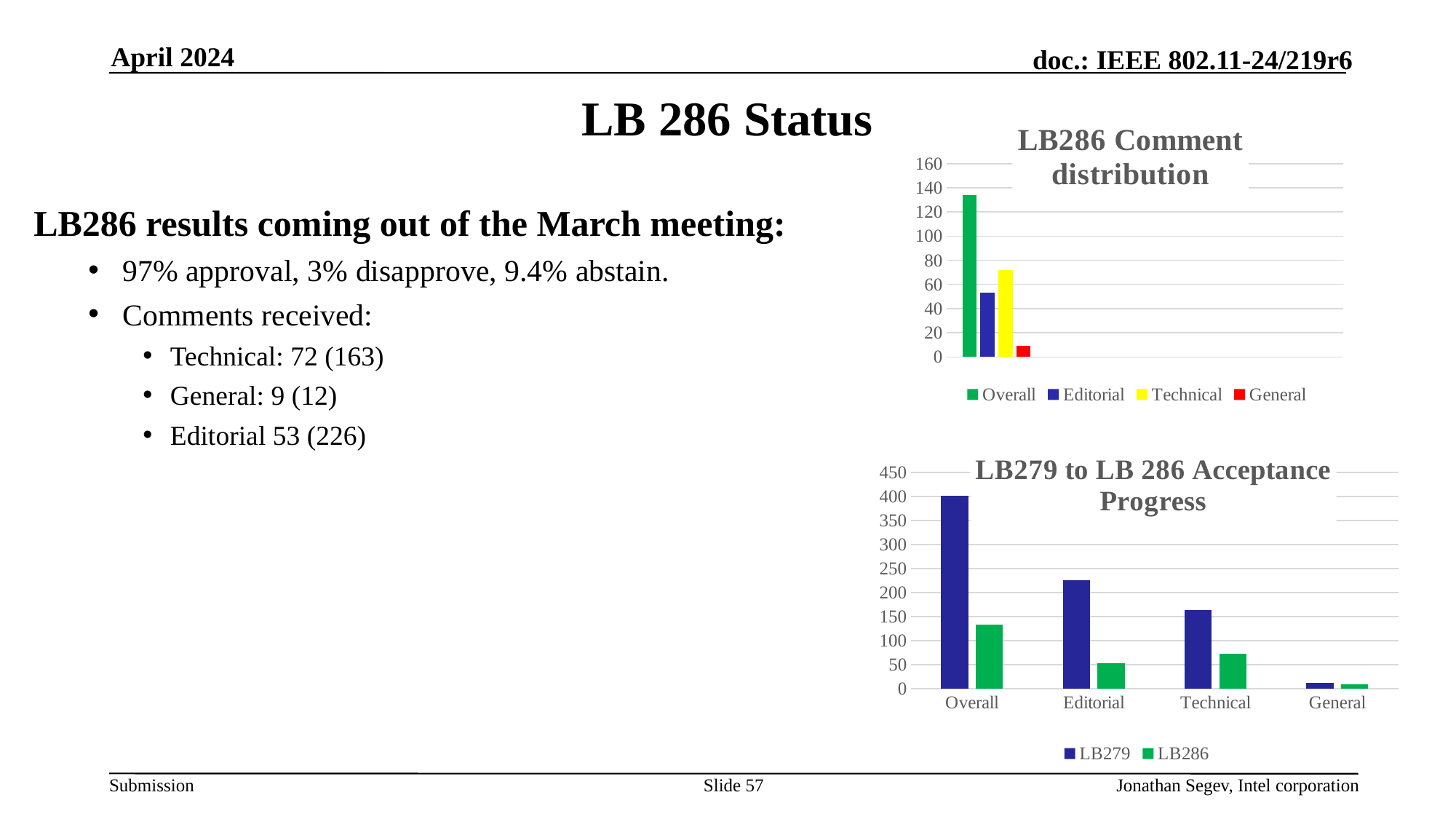
In the LB286 Comment distribution chart, what kind of chart is shown? bar chart In the LB279 to LB 286 Acceptance Progress chart, how many series does the legend list? 2 In the LB286 Comment distribution chart, which series has the shortest bar? General In the LB279 to LB 286 Acceptance Progress chart, is the LB279 value for Overall greater or less than 350? greater In the LB286 Comment distribution chart, is the value for Overall greater or less than 120? greater In the LB279 to LB 286 Acceptance Progress chart, which category has the highest LB279 value? Overall In the LB279 to LB 286 Acceptance Progress chart, how many categories are shown on the x axis? 4 In the LB286 Comment distribution chart, which series has the tallest bar? Overall In the LB286 Comment distribution chart, how many series does the legend list? 4 In the LB279 to LB 286 Acceptance Progress chart, which is larger for Editorial, LB279 or LB286? LB279 In the LB286 Comment distribution chart, which is larger, Editorial or Technical? Technical In the LB286 Comment distribution chart, is the value for Technical greater or less than 60? greater